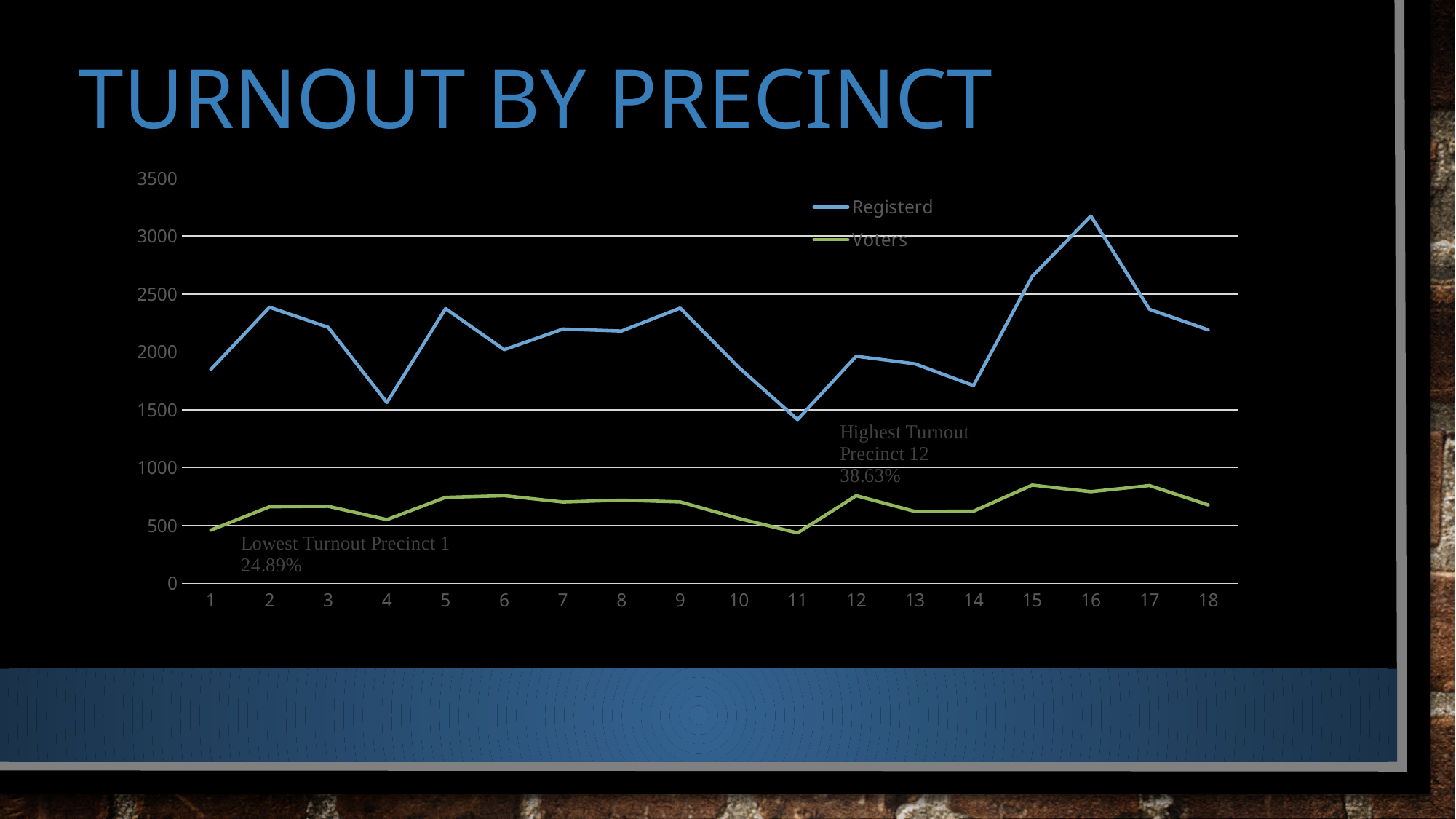
Which is larger, the Registerd value for precinct 2 or for precinct 4? precinct 2 According to the annotation on the chart, which precinct has the highest turnout and what is its percentage? Precinct 12, 38.63% How many precincts are plotted along the x axis? 18 Is the Registerd value for precinct 16 greater or less than 3000? greater Is the Voters value for precinct 12 greater or less than 500? greater Which precinct has the highest Registerd value? 16 How many series does the legend list? 2 Does the Registerd line rise or fall from precinct 16 to precinct 18? fall Which precinct has the lowest Registerd value? 11 What kind of chart is shown on the slide? line chart According to the annotation on the chart, what is the turnout percentage for the lowest turnout precinct (Precinct 1)? 24.89% Is the Registerd value for precinct 4 greater or less than 2000? less